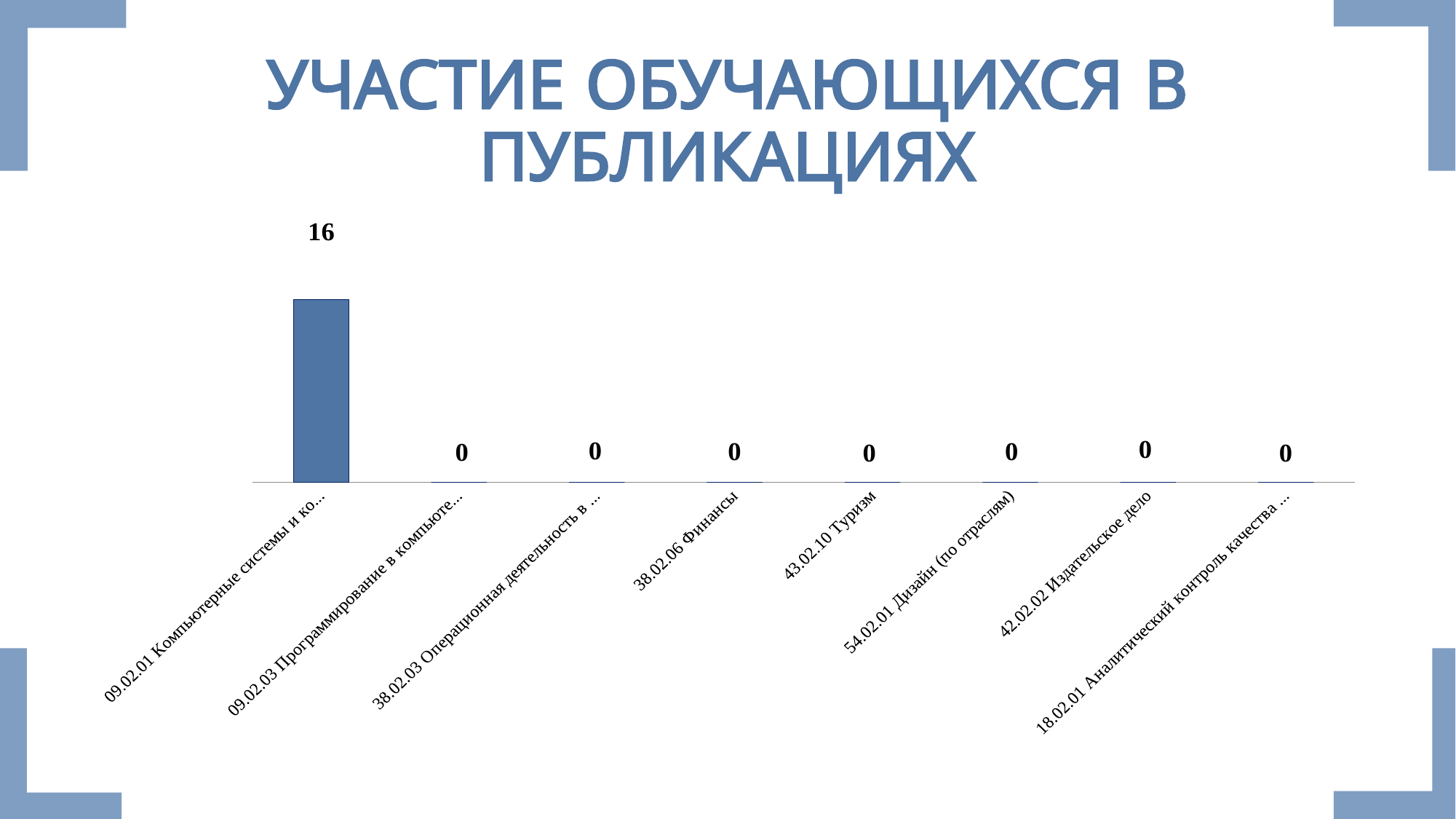
Which is larger, the value for 09.02.01 or the value for 38.02.06 Финансы? 09.02.01 What is the title of the slide? УЧАСТИЕ ОБУЧАЮЩИХСЯ В ПУБЛИКАЦИЯХ What is the difference between the value for 09.02.01 and the value for 54.02.01 Дизайн (по отраслям)? 16 What is the value for the category whose code is 09.02.01? 16 How many categories have a value of 0? 7 What is the value for 43.02.10 Туризм? 0 What kind of chart is shown on the slide? bar chart How many categories are shown on the x axis? 8 Which category has the highest value? 09.02.01 Компьютерные системы и ко... What colour is the bar for 09.02.01? blue What is the value for 42.02.02 Издательское дело? 0 What is the value for 38.02.06 Финансы? 0